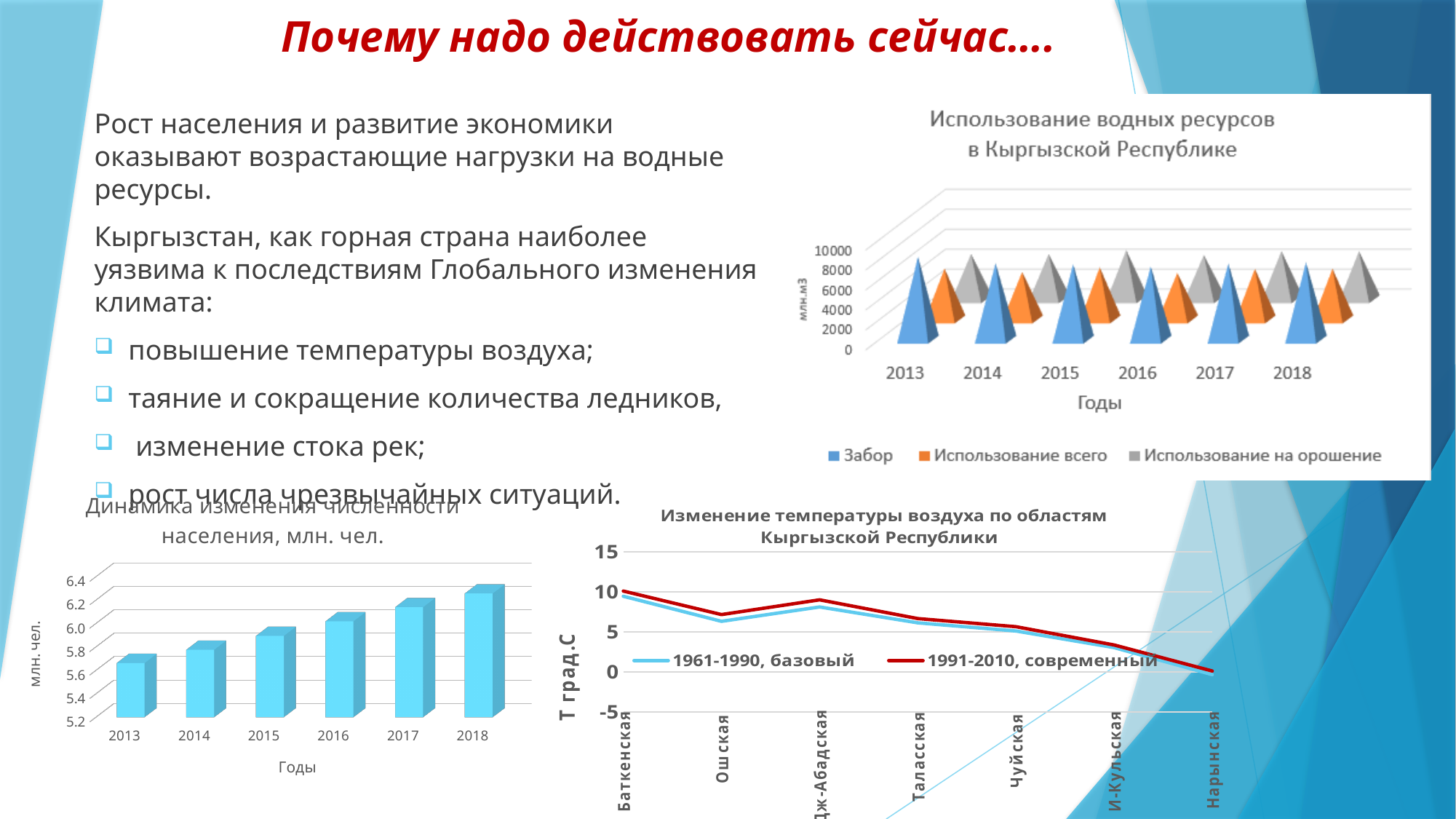
In the 'Динамика изменения численности населения' chart, is the value for 2018 greater or less than 6.0? greater In the 'Динамика изменения численности населения' chart, is the value for 2013 greater or less than 5.8? less In the 'Изменение температуры воздуха по областям Кыргызской Республики' chart, which region has the lowest temperature for the 1991-2010 series? Нарынская In the 'Изменение температуры воздуха по областям Кыргызской Республики' chart, is the value for Баткенская in the 1991-2010 series greater or less than 5? greater In the 'Динамика изменения численности населения' chart, which year has the lowest value? 2013 In the 'Динамика изменения численности населения' chart, how many years are shown on the x axis? 6 In the 'Динамика изменения численности населения' chart, do the values rise or fall from 2013 to 2018? rise How many series does the legend of the 'Использование водных ресурсов в Кыргызской Республике' chart list? 3 What type of chart is the 'Динамика изменения численности населения, млн. чел.' chart? bar chart In the 'Динамика изменения численности населения' chart, which year has the highest value? 2018 In the 'Использование водных ресурсов в Кыргызской Республике' chart, which series has the highest value in 2013? Забор